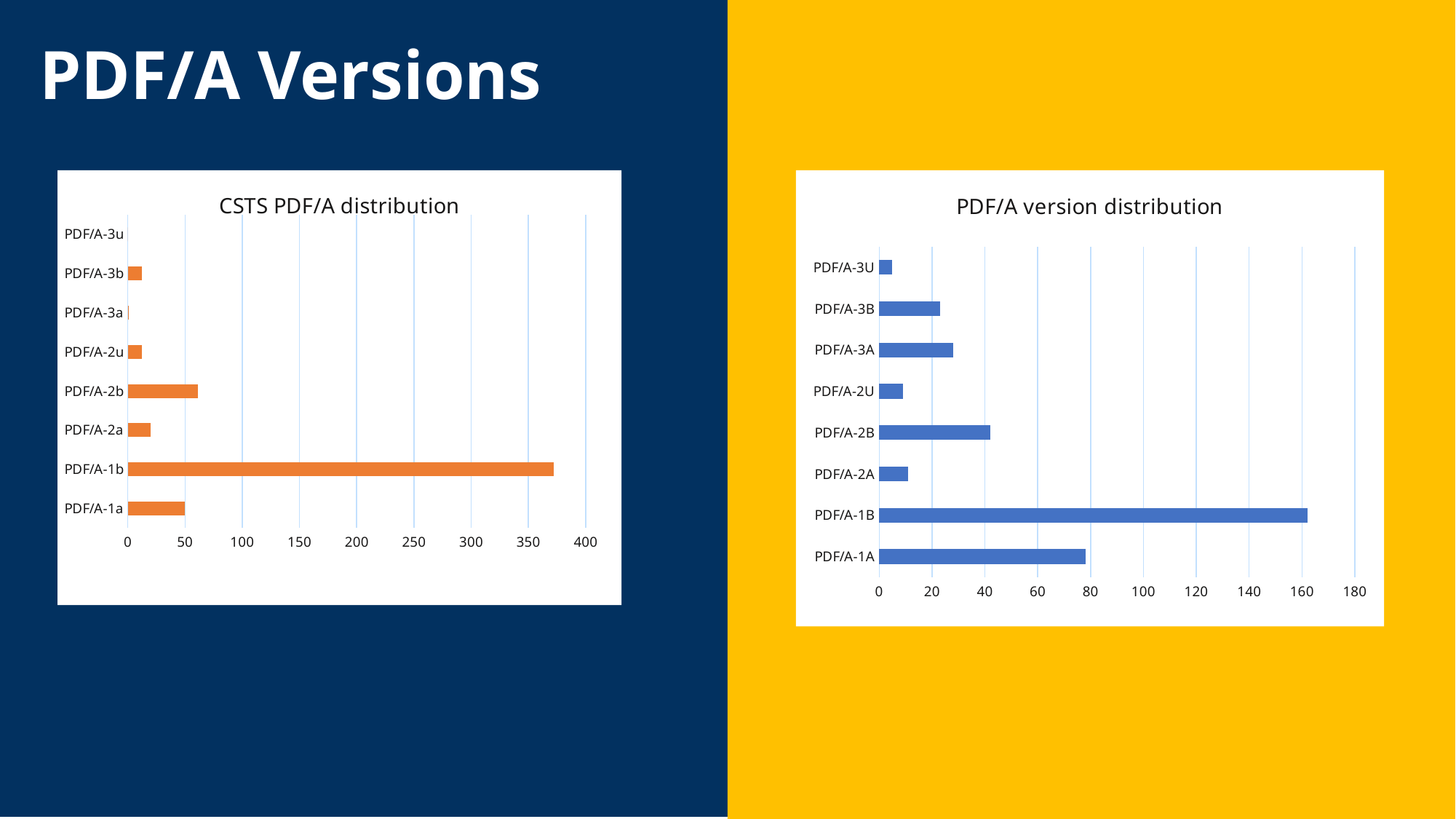
What colour are the bars in the 'PDF/A version distribution' chart? blue In the 'CSTS PDF/A distribution' chart, is the value for PDF/A-2b greater or less than 50? greater In the 'CSTS PDF/A distribution' chart, which category has the highest value? PDF/A-1b In the 'CSTS PDF/A distribution' chart, is the value for PDF/A-1b greater or less than 350? greater How many categories are shown in the 'PDF/A version distribution' chart? 8 In the 'PDF/A version distribution' chart, is the value for PDF/A-1B greater or less than 140? greater In the 'PDF/A version distribution' chart, which is larger, PDF/A-3A or PDF/A-3B? PDF/A-3A In the 'CSTS PDF/A distribution' chart, which is larger, PDF/A-2b or PDF/A-2a? PDF/A-2b In the 'PDF/A version distribution' chart, which category has the lowest value? PDF/A-3U In the 'PDF/A version distribution' chart, which category has the highest value? PDF/A-1B What kind of chart is the 'CSTS PDF/A distribution' chart? bar chart